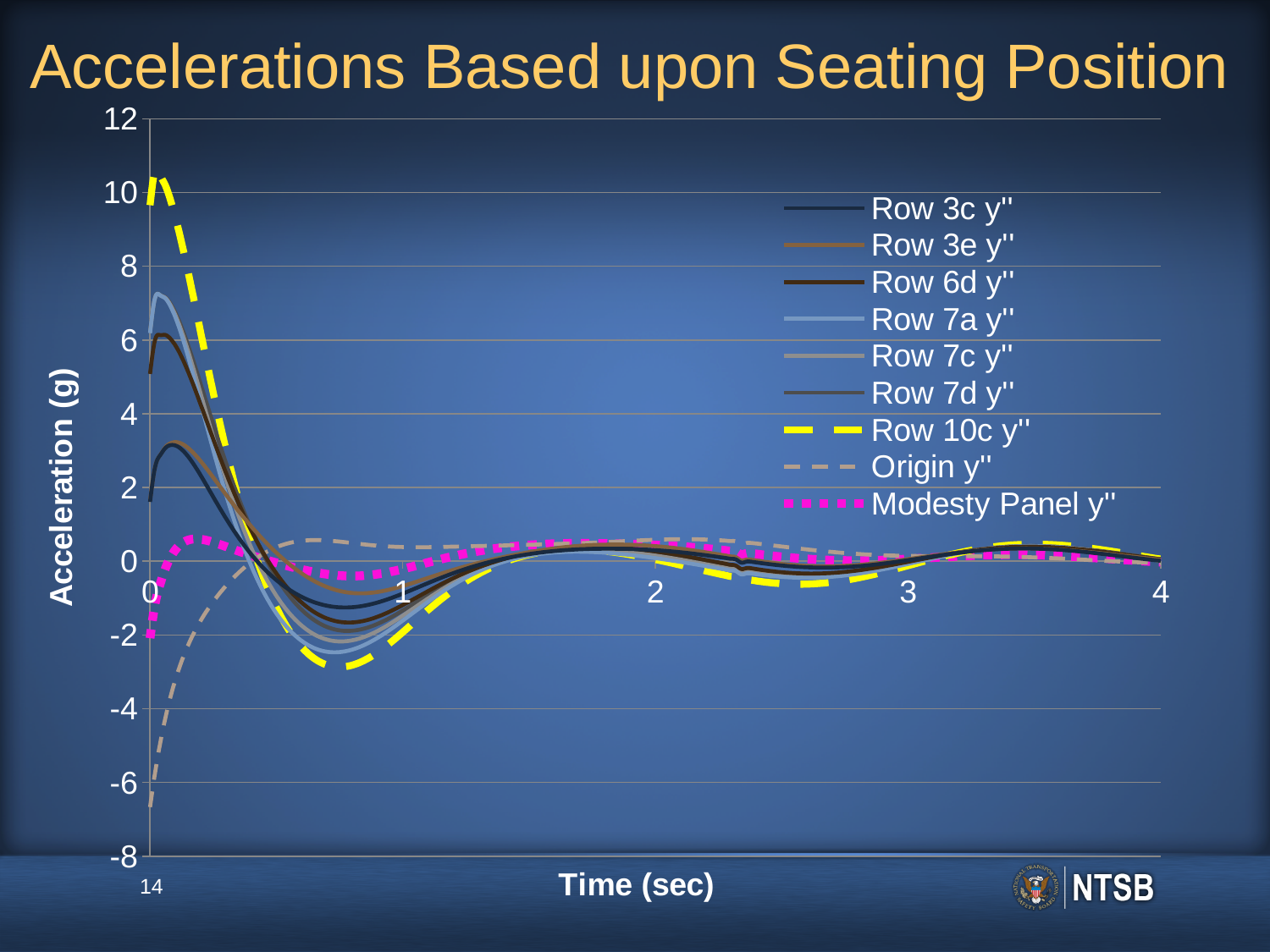
What is the title of the chart? Accelerations Based upon Seating Position Which series reaches the highest peak acceleration? Row 10c y'' What is the maximum value shown on the vertical axis? 12 Is the starting value of Origin y'' at time 0 greater or less than -4? less Is the peak value of Row 10c y'' greater or less than 8? greater Which series has a higher peak near time 0: Row 7a y'' or Row 3c y''? Row 7a y'' Between time 0.2 and time 1, does the Row 10c y'' line rise or fall? fall What kind of chart is shown on the slide? line chart Which series reaches the lowest (most negative) acceleration value? Origin y'' How many series does the legend list? 9 What is the label of the vertical axis? Acceleration (g) Is the peak value of Row 3c y'' greater or less than 4? less